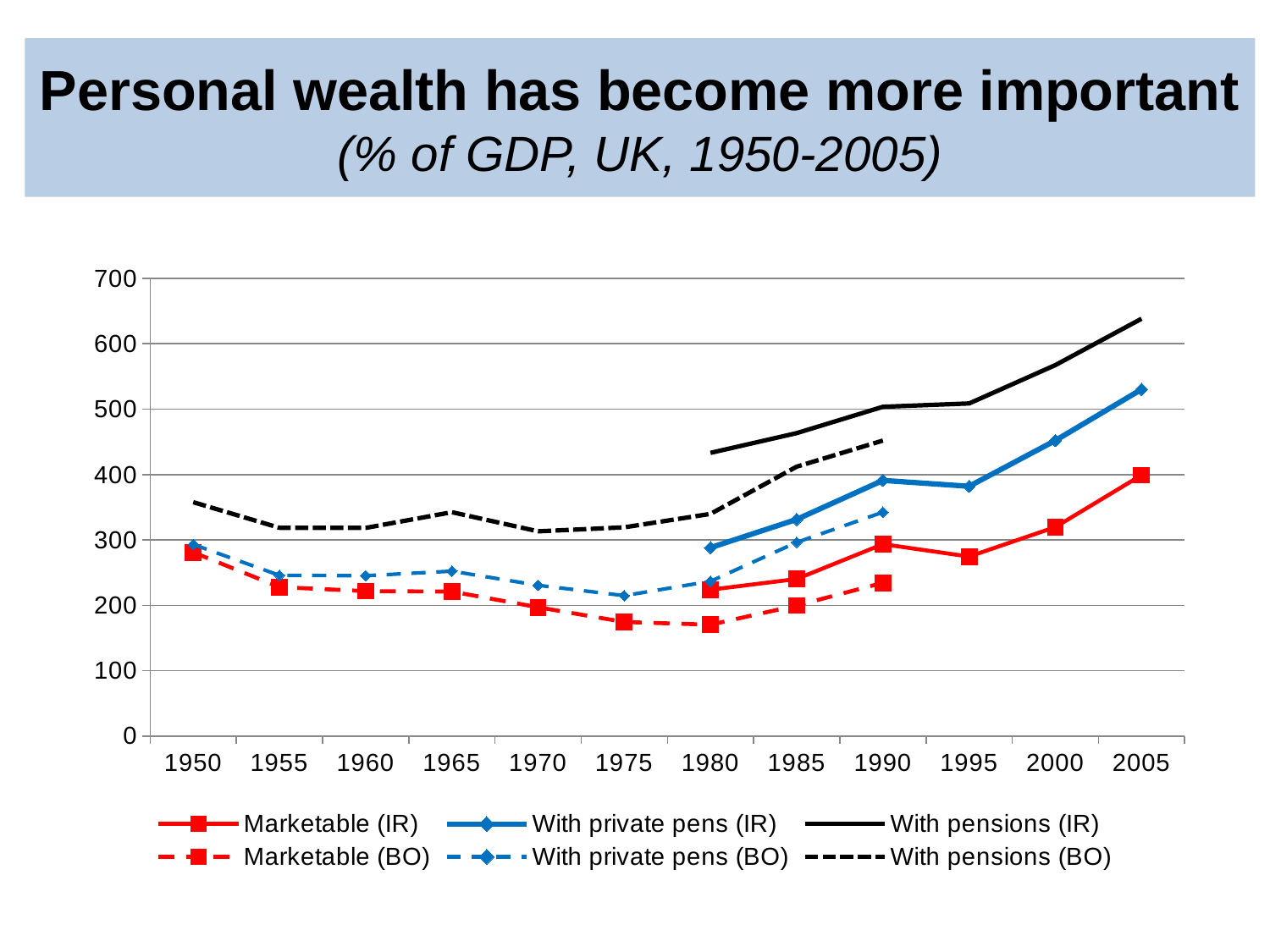
Which series has the highest value in 2005? With pensions (IR) Does the With pensions (IR) series rise or fall from 1980 to 2005? Rises Is the value for Marketable (BO) in 1975 greater or less than 200? less In which year do the (IR) series first appear on the chart? 1980 What kind of chart is shown on the slide? Line chart Is the value for With pensions (BO) in 1950 greater or less than 300? greater Which series has the lowest value in 1990? Marketable (BO) In 1990, which is larger: With pensions (IR) or With pensions (BO)? With pensions (IR) How many years are labelled on the x axis? 12 Is the value for With private pens (IR) in 2005 greater or less than 500? greater How many series does the legend list? 6